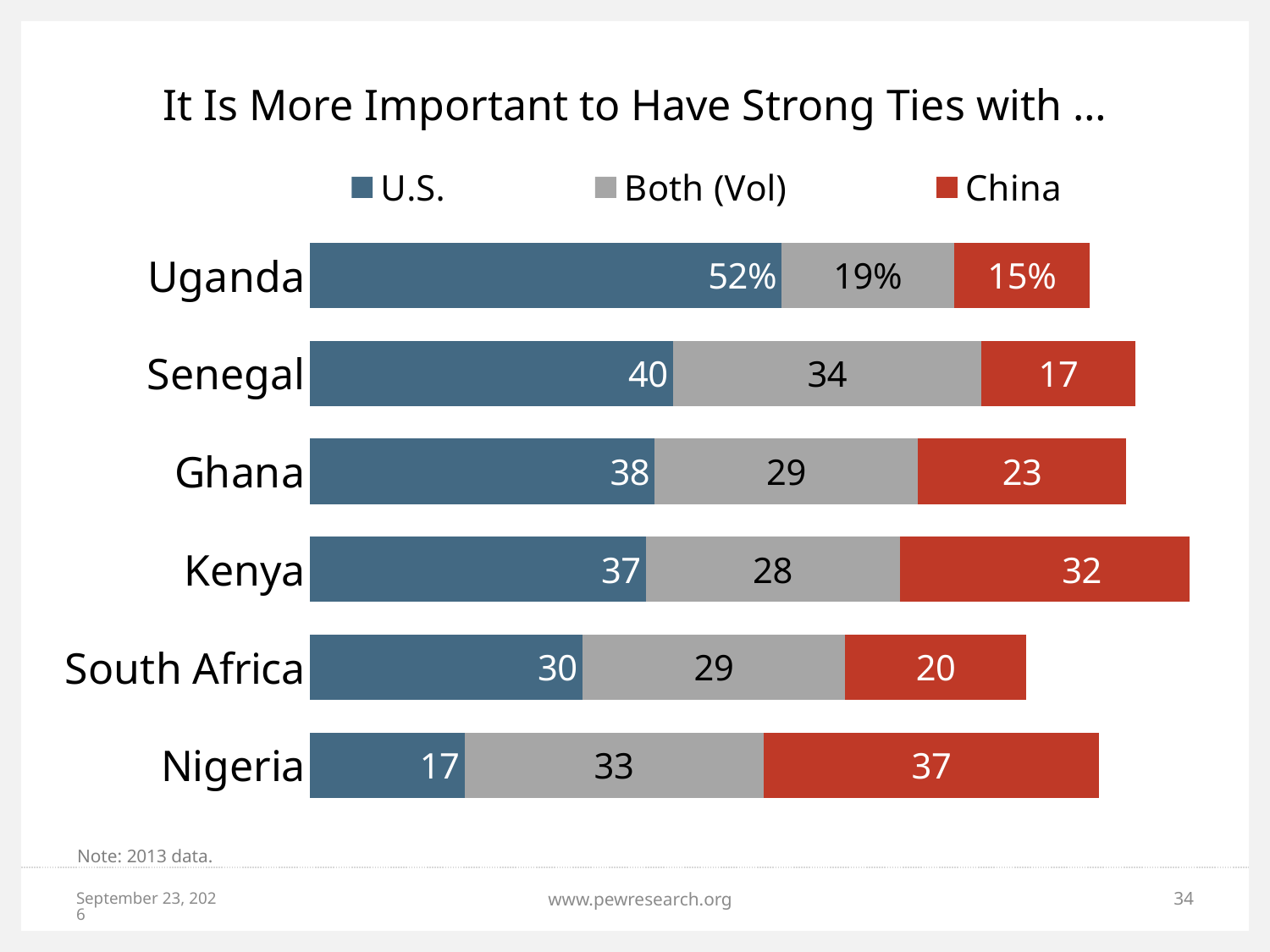
Which is larger for Ghana, the U.S. value or the China value? U.S. What is the U.S. value for Uganda? 52% What is the total of the three segments for South Africa? 79 How many countries are shown in the chart? 6 What is the difference between the U.S. and China values for Kenya? 5 What kind of chart is shown on the slide? Stacked bar chart What colour represents China in the chart? Red What is the China value for Nigeria? 37 Which country has the highest U.S. value? Uganda Which country has the lowest China value? Uganda What is the Both (Vol) value for Senegal? 34 How many series does the legend list? 3